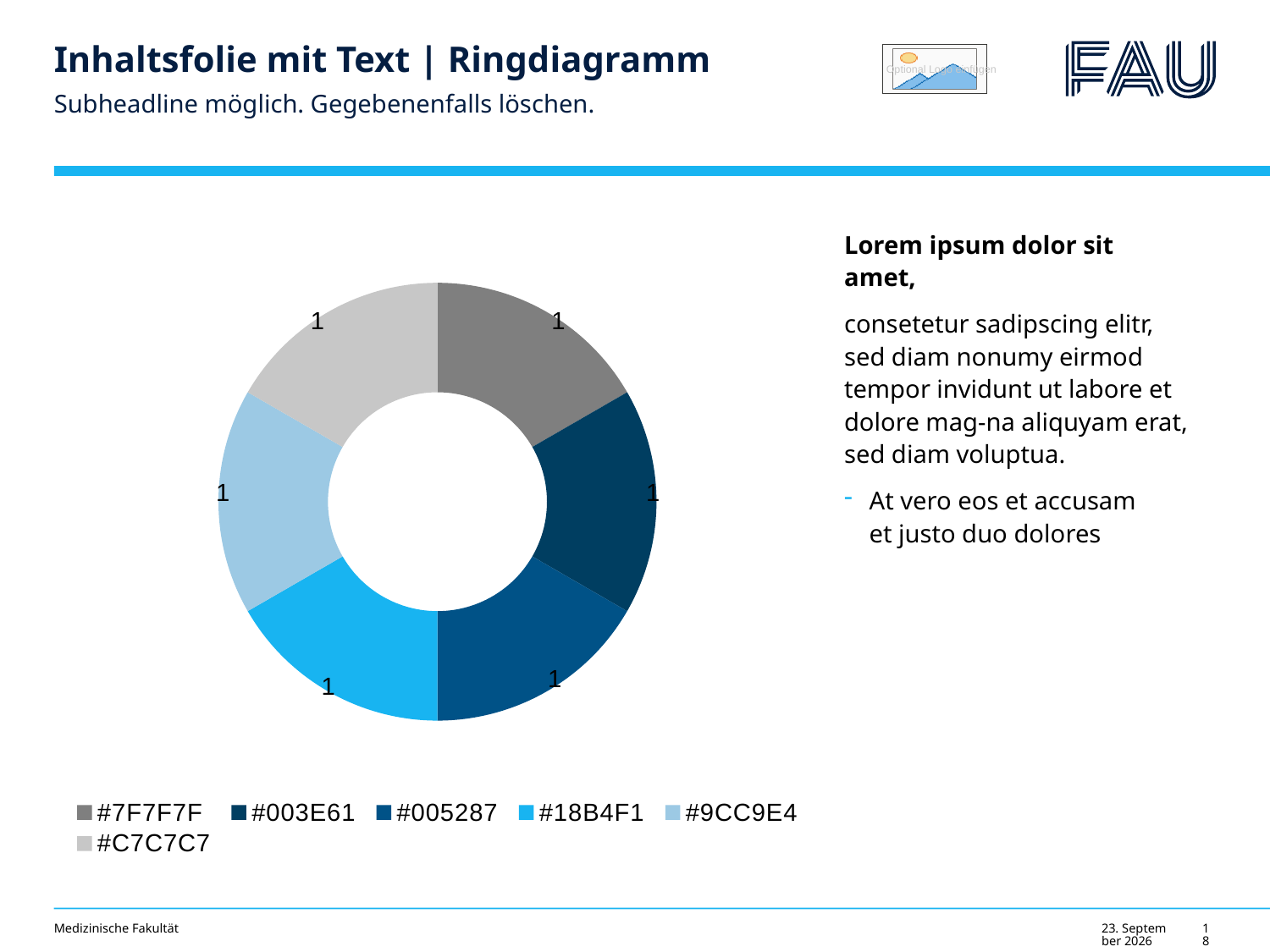
What is the value of the #003E61 segment? 1 How many entries does the chart legend list? 6 What is the value of the #7F7F7F segment? 1 What kind of chart is shown on the slide? Doughnut chart What is the value of the #18B4F1 segment? 1 What is the difference between the values of the #005287 and #9CC9E4 segments? 0 Which legend entry is listed last in the chart legend? #C7C7C7 Which legend entry is listed first in the chart legend? #7F7F7F Is the value of the #003E61 segment larger than, smaller than, or equal to the value of the #9CC9E4 segment? Equal What is the total of all segment values in the doughnut chart? 6 How many segments does the doughnut chart have? 6 What is the value of the #C7C7C7 segment? 1